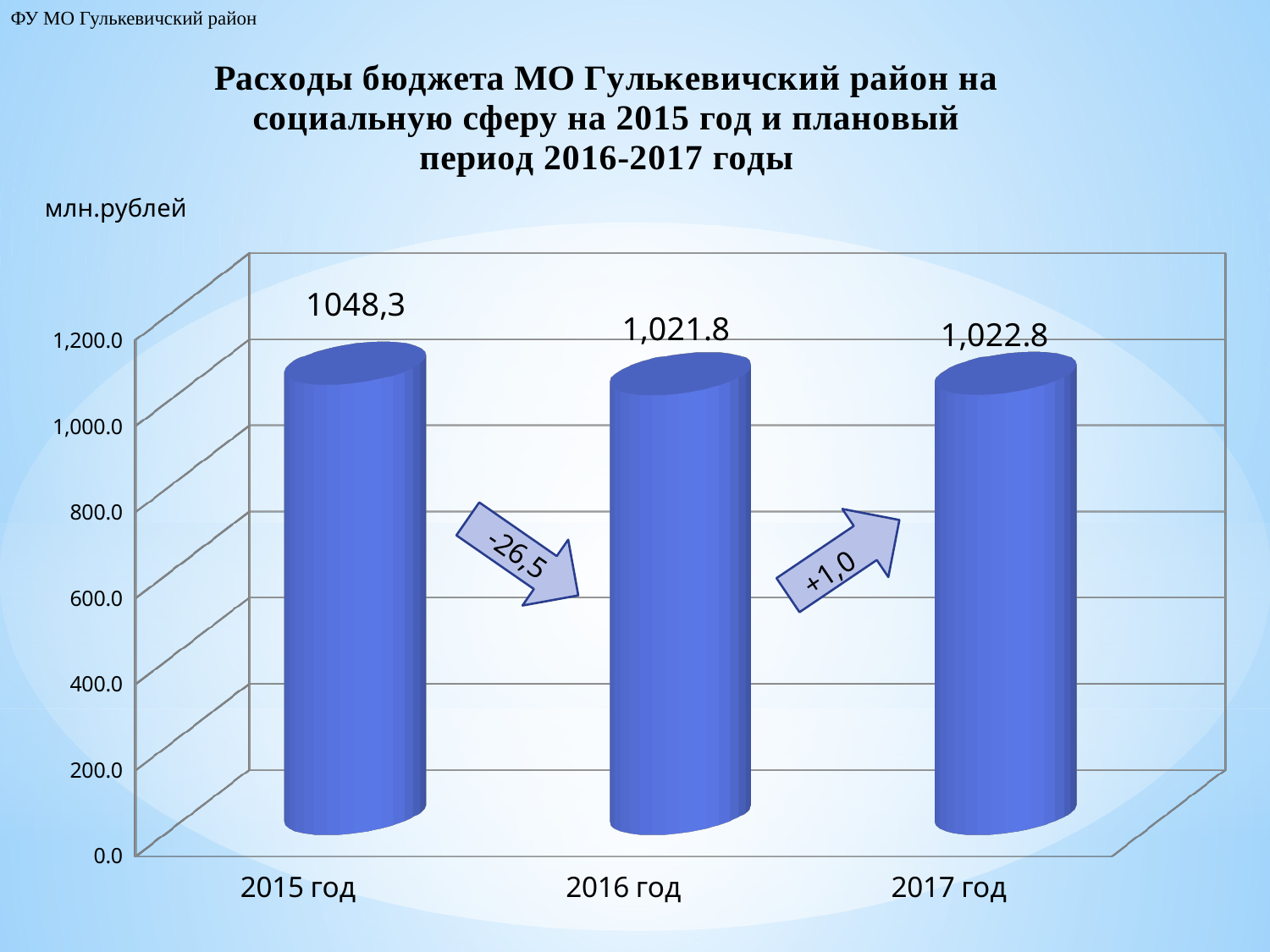
Which year has the highest value? 2015 год By how much does the value change from 2015 год to 2016 год, as shown on the arrow? -26,5 What is the value for 2015 год? 1048,3 What is the value for 2017 год? 1,022.8 Is the value for 2015 год greater or less than 1,200.0? less What unit of measurement is indicated above the chart? млн.рублей What kind of chart is shown on the slide? bar chart Which is larger, the value for 2015 год or the value for 2016 год? 2015 год Is the value for 2016 год greater or less than 1,000.0? greater By how much does the value change from 2016 год to 2017 год, as shown on the arrow? +1,0 How many years are shown on the chart? 3 What is the value for 2016 год? 1,021.8